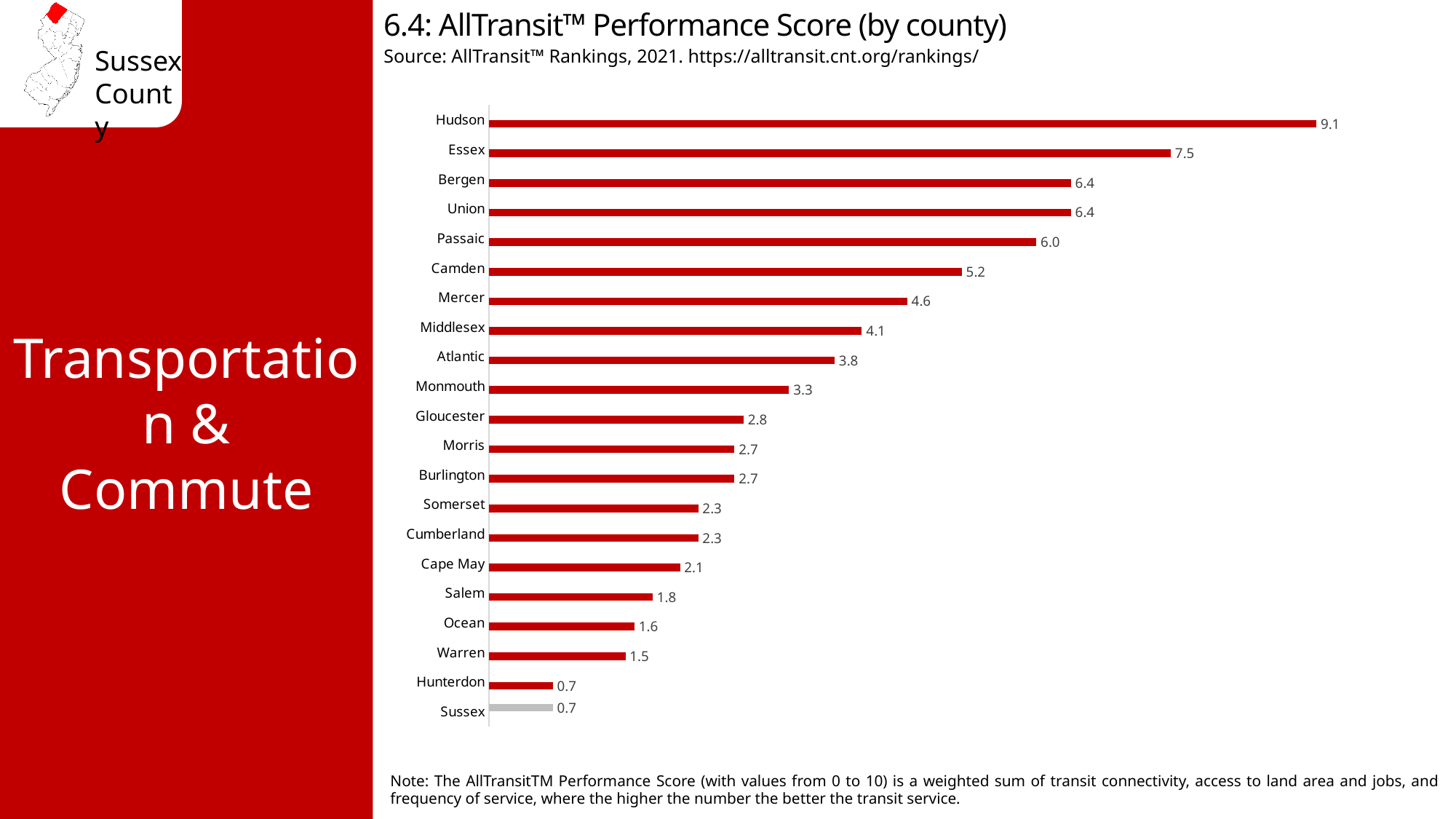
What is the AllTransit Performance Score for Mercer county? 4.6 Which county has a higher AllTransit Performance Score, Warren or Monmouth? Monmouth Which county has a higher AllTransit Performance Score, Camden or Middlesex? Camden What is the difference between the AllTransit Performance Scores of Passaic and Sussex? 5.3 What is the difference between the AllTransit Performance Scores of Hudson and Essex? 1.6 How many counties are shown in the chart? 21 Which county has the highest AllTransit Performance Score? Hudson What type of chart is used to show the AllTransit Performance Score by county? Bar chart What is the AllTransit Performance Score for Sussex county? 0.7 What is the AllTransit Performance Score for Hudson county? 9.1 Which county's bar is shown in grey rather than red? Sussex What is the AllTransit Performance Score for Cape May county? 2.1